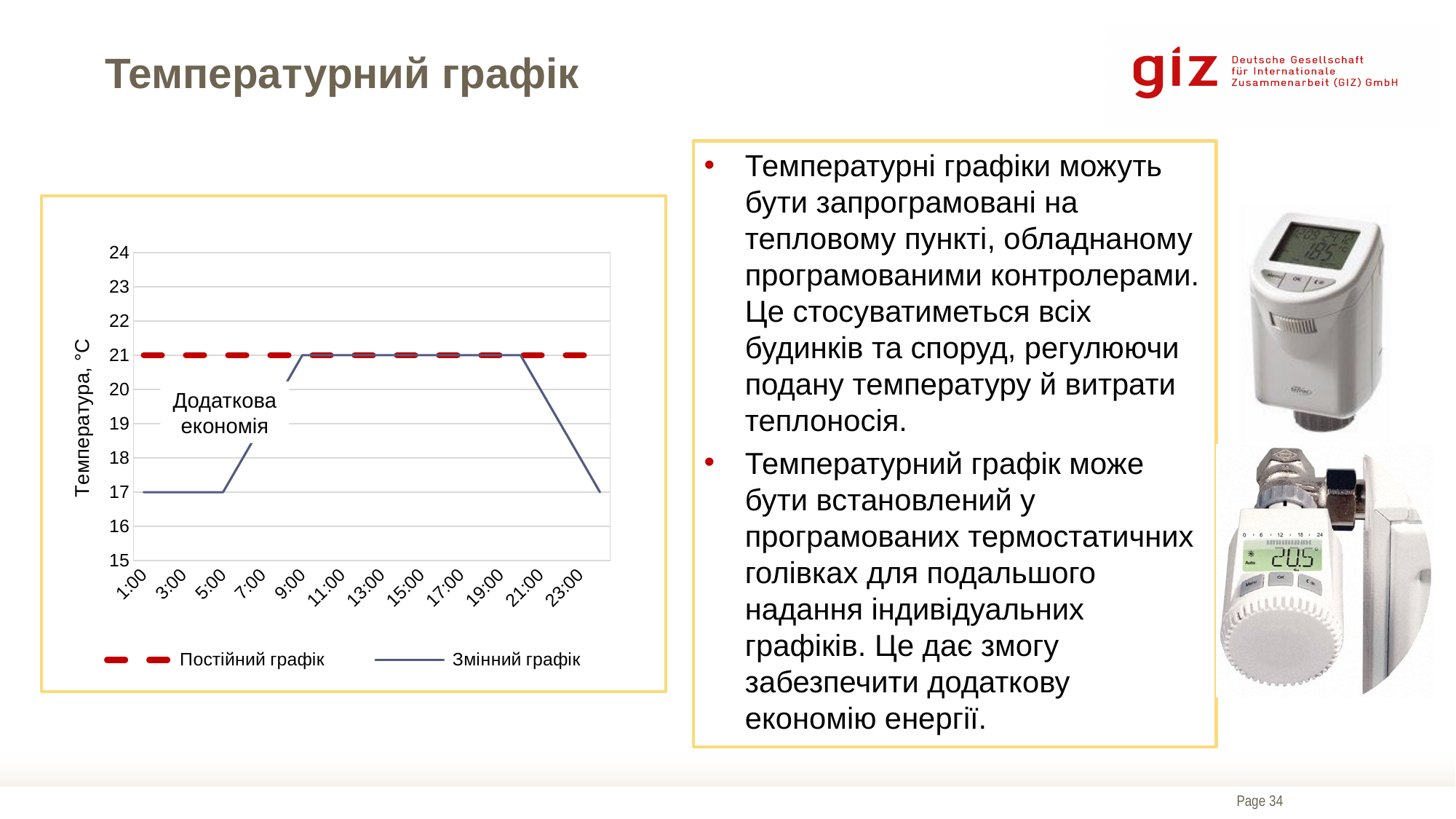
How many time labels are shown on the x axis of the chart? 12 What is the difference between the 'Постійний графік' value and the 'Змінний графік' value at 3:00? 4 What kind of chart is shown on the slide? line chart How many series does the chart legend list? 2 What is the value of the 'Змінний графік' series at 13:00? 21 Is the value of the 'Змінний графік' series at 23:00 greater or less than 20? less Does the 'Змінний графік' series rise or fall between 5:00 and 9:00? rise What is the label of the y axis of the chart? Температура, °C What temperature does the 'Постійний графік' series hold throughout the day? 21 At 5:00, which series has the higher value, 'Постійний графік' or 'Змінний графік'? Постійний графік What is the value of the 'Змінний графік' series at 1:00? 17 What are the two series named in the chart legend? Постійний графік and Змінний графік